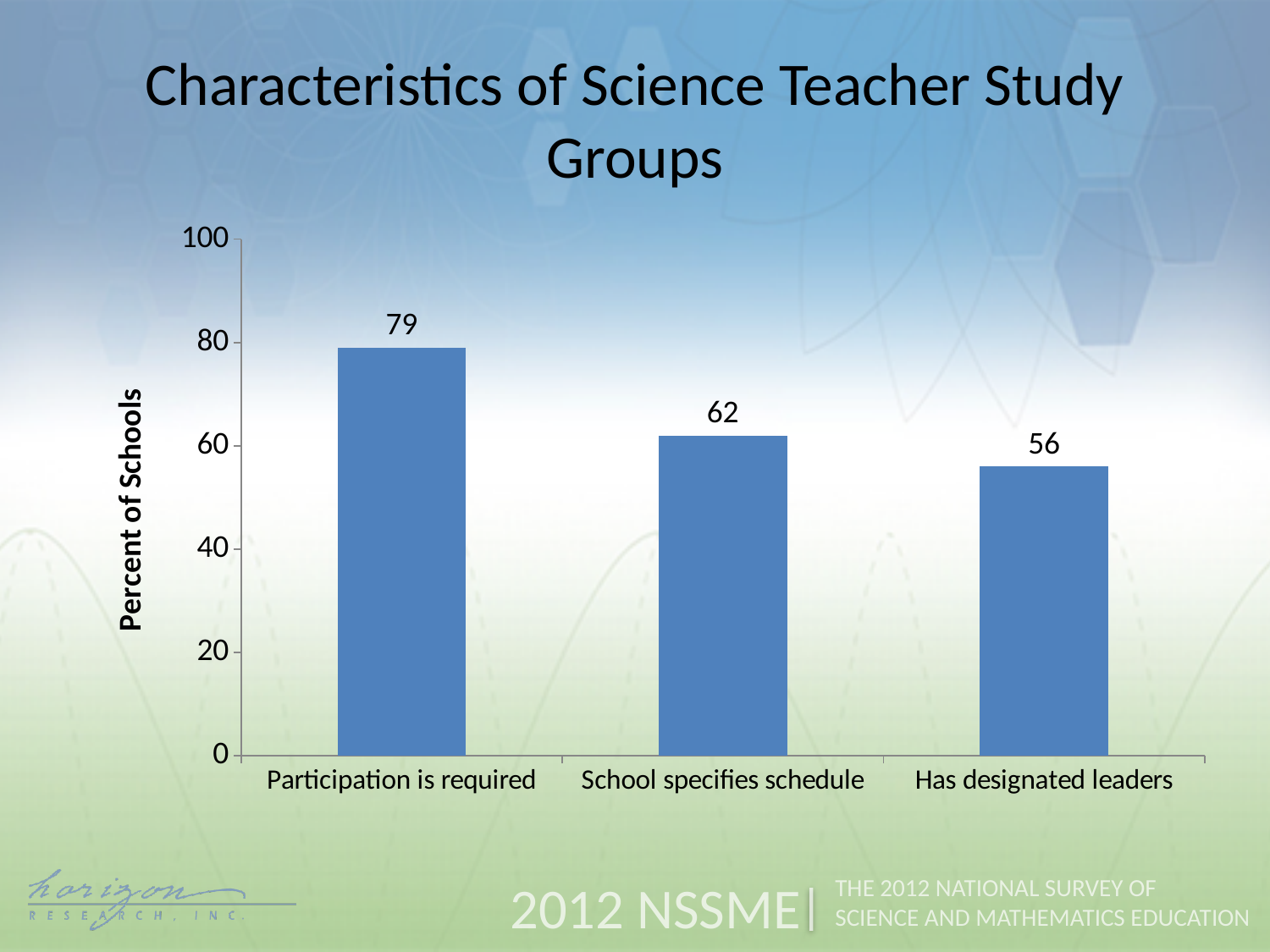
What is the value for Has designated leaders? 56 What is the difference between the values for School specifies schedule and Has designated leaders? 6 What is the value for Participation is required? 79 What kind of chart is shown on the slide? bar chart Which is larger, the value for School specifies schedule or the value for Has designated leaders? School specifies schedule What is the value for School specifies schedule? 62 Is the value for Participation is required greater or less than 60? greater Which category has the lowest value? Has designated leaders How many categories are shown on the chart? 3 What is the label of the vertical axis? Percent of Schools What is the difference between the values for Participation is required and Has designated leaders? 23 Which category has the highest value? Participation is required